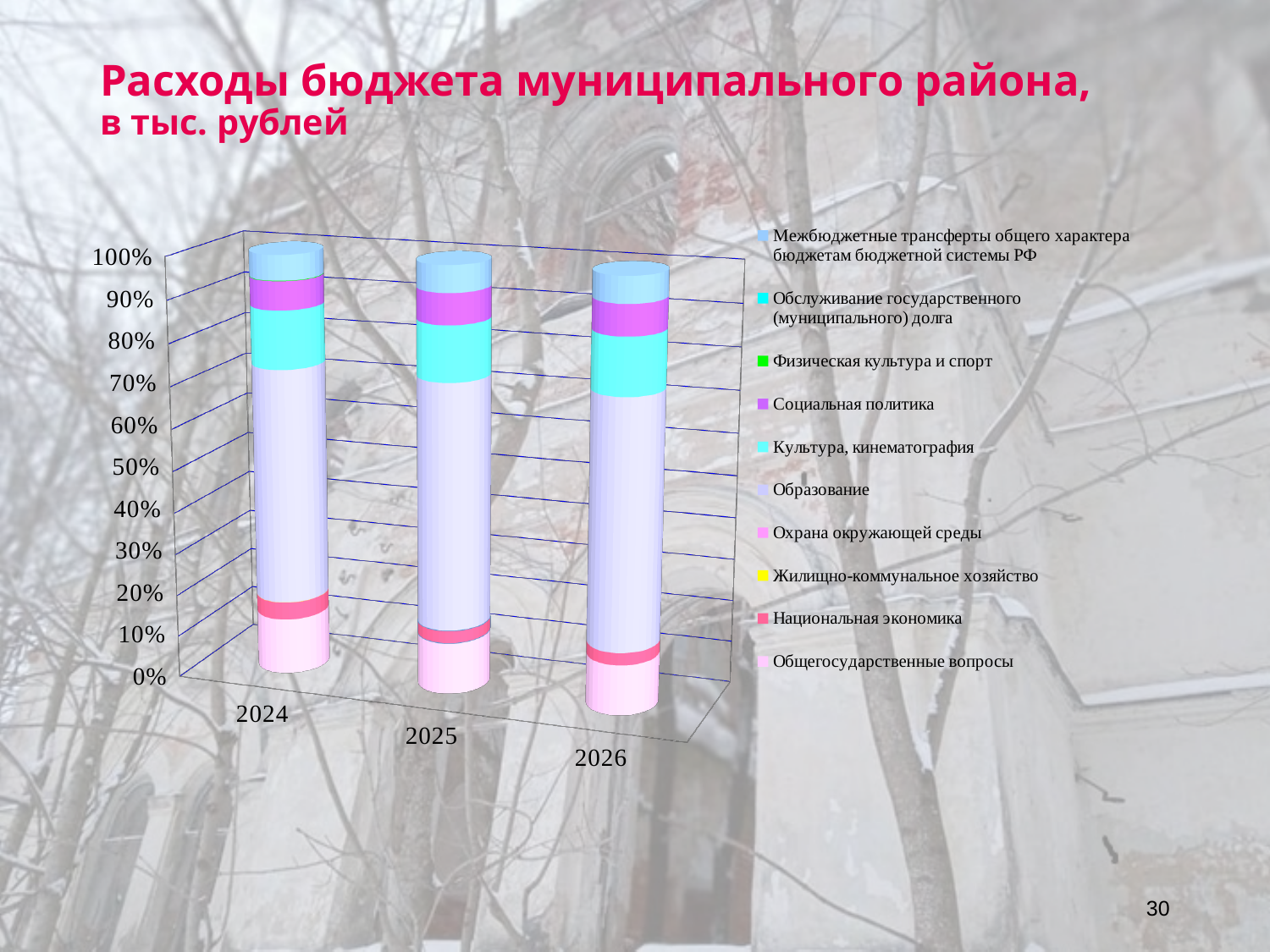
How many series does the chart legend list? 10 How many years (categories) are shown on the x axis of the chart? 3 Which series is listed last in the chart legend? Общегосударственные вопросы Which series takes up the largest share of the 2026 bar? Образование Is the share of Социальная политика in the 2025 bar greater or less than 20%? less Is the share of Культура, кинематография in the 2026 bar greater or less than 40%? less What kind of chart is shown on the slide? Stacked bar chart What is the highest value shown on the vertical axis of the chart? 100% Which series takes up the largest share of the 2024 bar? Образование What is the title of the chart on the slide? Расходы бюджета муниципального района, в тыс. рублей Is the share of Образование in the 2024 bar greater or less than 40%? greater